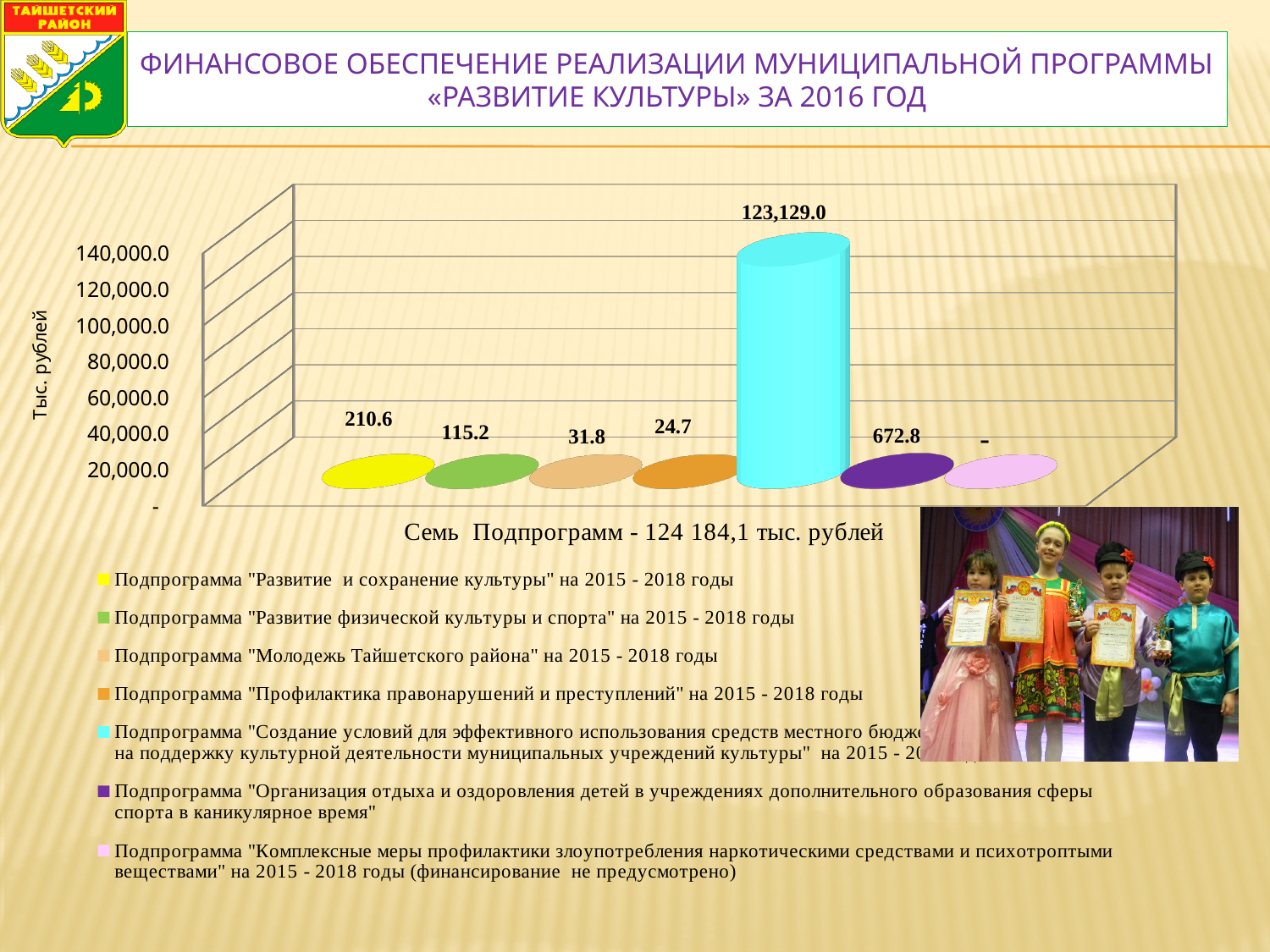
What is the value for the subprogram "Молодежь Тайшетского района"? 31.8 What is the value for the subprogram "Развитие физической культуры и спорта"? 115.2 What is the difference between the values for "Развитие и сохранение культуры" and "Развитие физической культуры и спорта"? 95.4 How many bars are plotted on the chart? 7 Which is larger: the value for "Молодежь Тайшетского района" or the value for "Профилактика правонарушений и преступлений"? Молодежь Тайшетского района Which subprogram has the highest value on the chart? Подпрограмма "Создание условий для эффективного использования средств местного бюджета на поддержку культурной деятельности муниципальных учреждений культуры" What is the label of the vertical axis of the chart? Тыс. рублей What is the value for the subprogram "Организация отдыха и оздоровления детей в учреждениях дополнительного образования сферы спорта в каникулярное время"? 672.8 What type of chart is shown on the slide? bar chart Is the value for the subprogram "Создание условий для эффективного использования средств местного бюджета..." greater or less than 120,000.0? greater Which subprogram has the lowest non-zero value on the chart? Подпрограмма "Профилактика правонарушений и преступлений" What is the value for the subprogram "Развитие и сохранение культуры"? 210.6